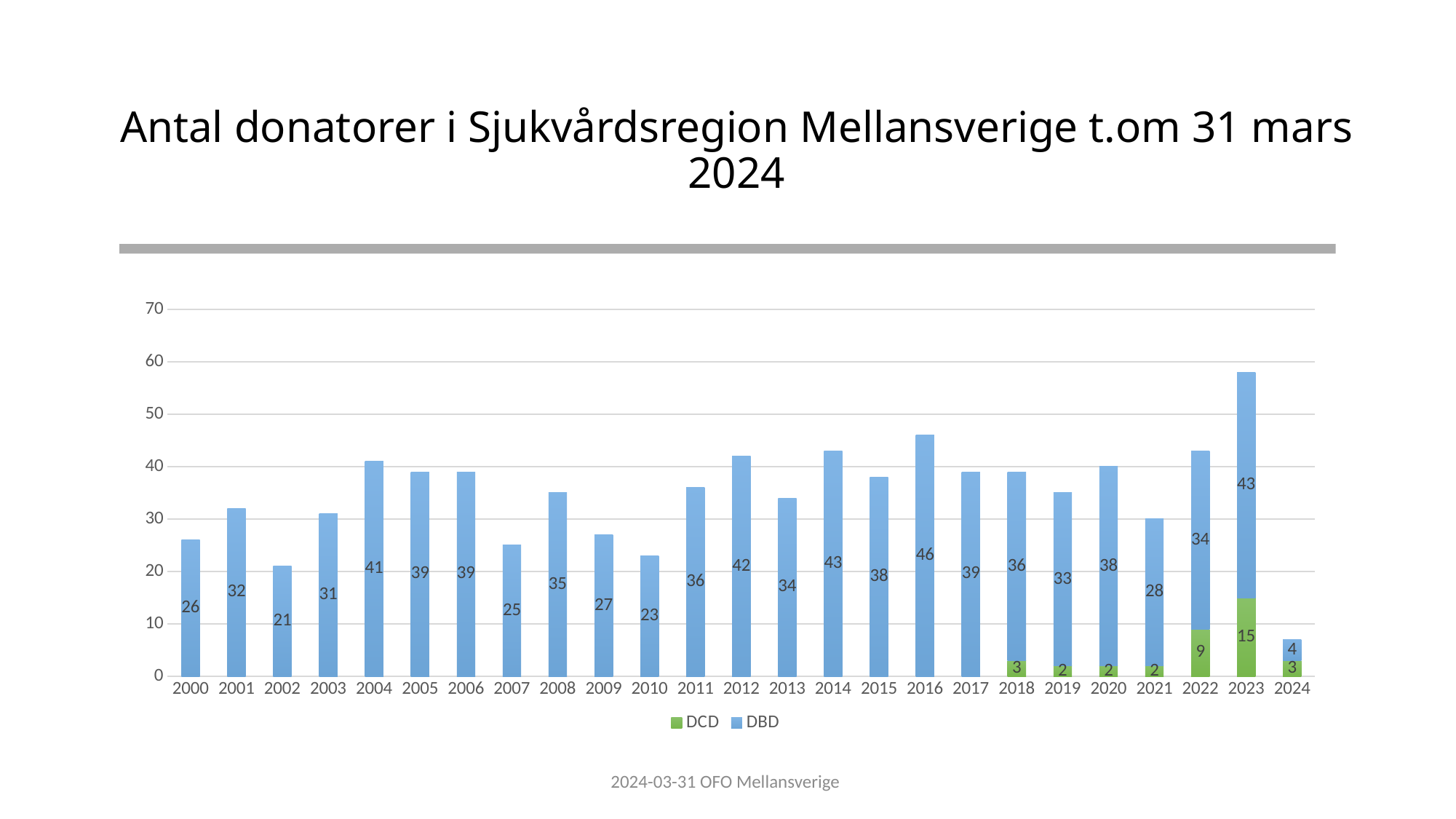
What is the total height of the stacked bar for 2023 (DCD plus DBD)? 58 What is the difference between the DBD values for 2004 and 2002? 20 What kind of chart is shown on the slide? Stacked bar chart What is the DCD value for 2023? 15 Is the total stacked bar for 2023 greater or less than 50? greater Which year has the lowest DBD value? 2024 What is the DBD value for 2016? 46 How many series does the legend list? 2 How many years are shown on the x axis? 25 What is the DBD value for 2024? 4 Which year has the larger DBD value, 2012 or 2013? 2012 Which year has the highest DBD value? 2016